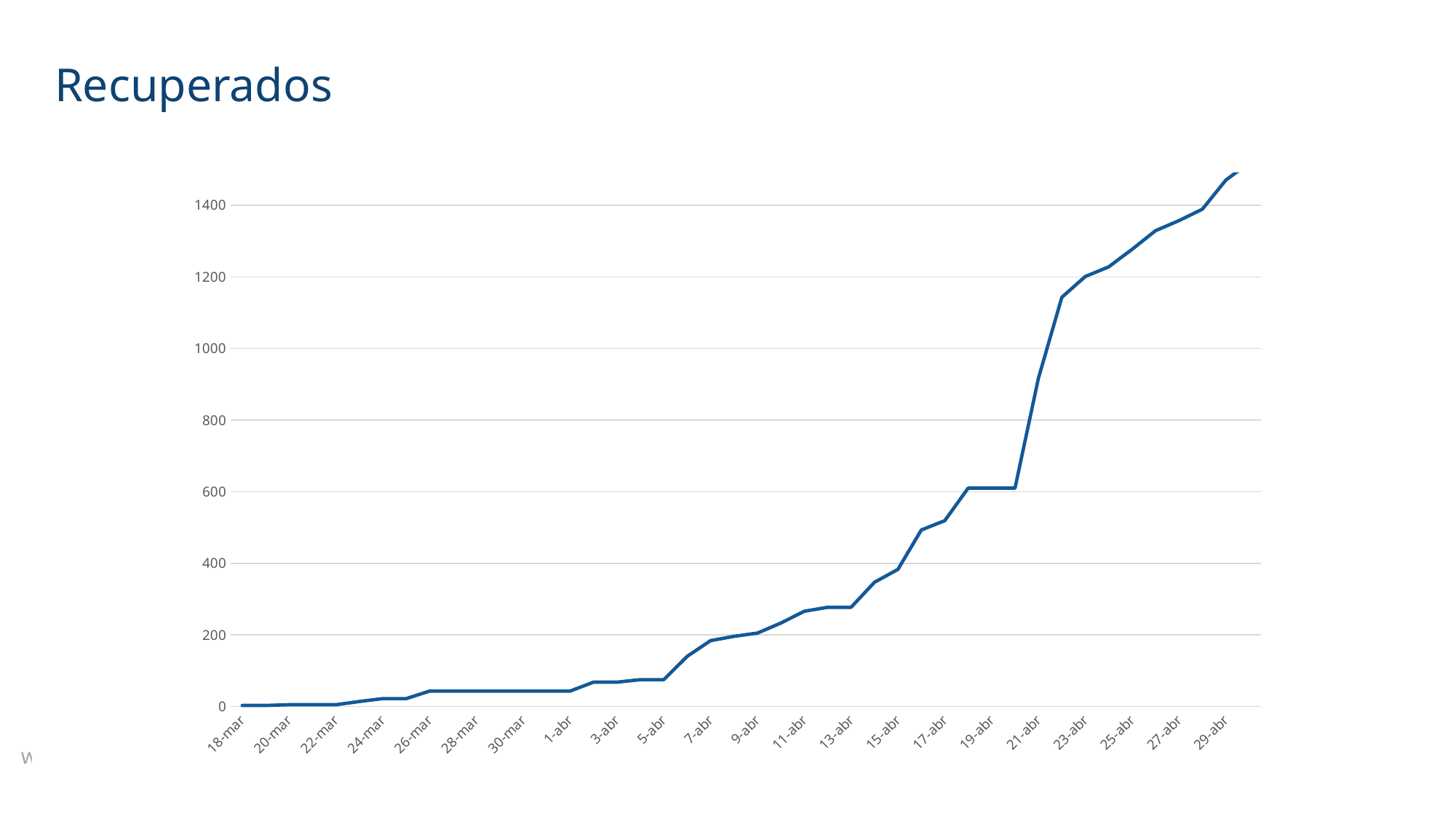
Is the value for 21-abr greater or less than 1000? less What kind of chart is shown on the slide? Line chart Is the value for 29-abr greater or less than 1400? greater Do the values rise or fall from 18-mar to 29-abr? Rise What is the title of the chart? Recuperados Which date has the larger value, 7-abr or 27-abr? 27-abr What is the first date label on the x axis? 18-mar Is the value for 13-abr greater or less than 400? less Which date has the larger value, 19-abr or 21-abr? 21-abr